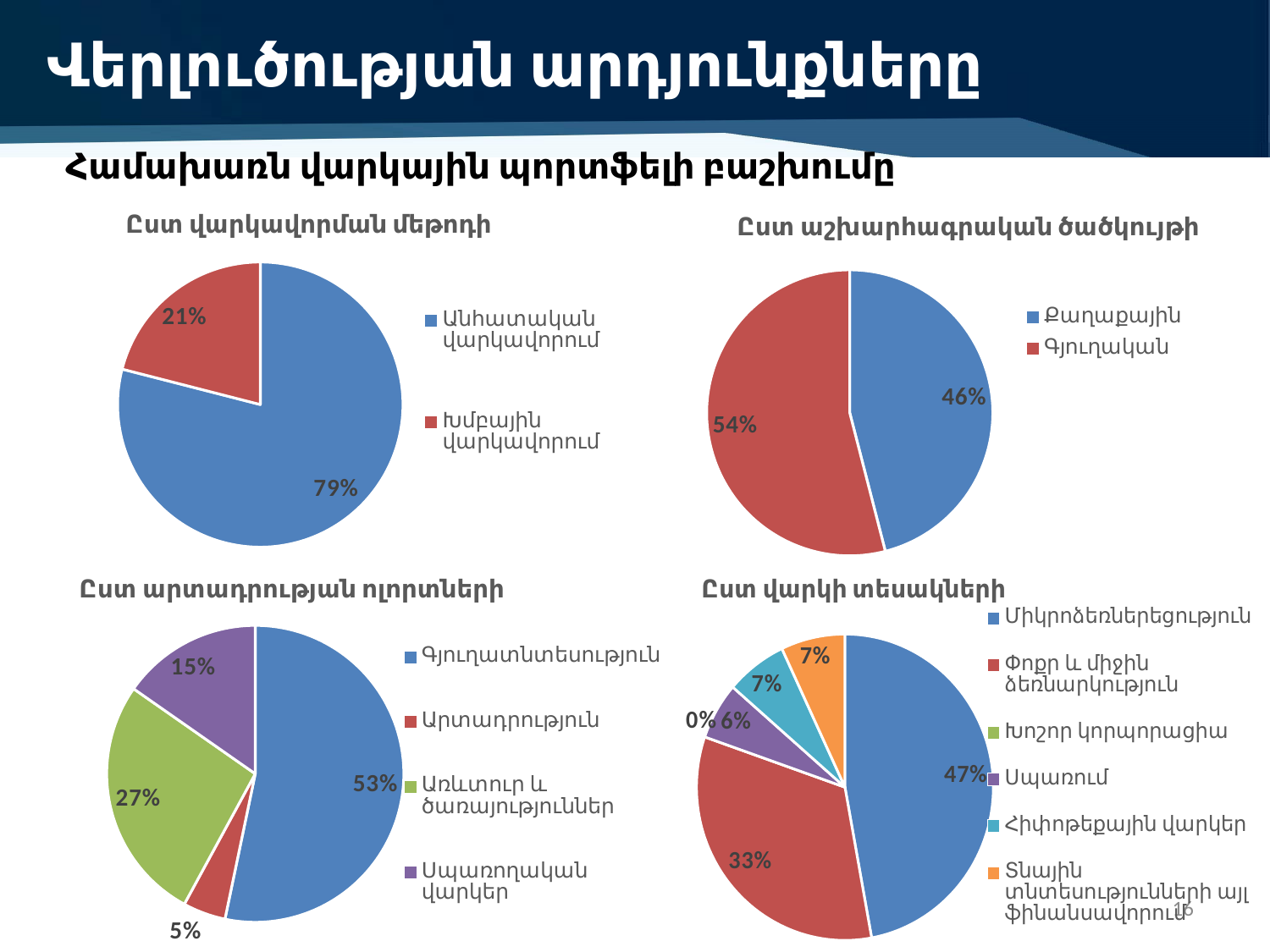
In the chart titled "Ըստ վարկի տեսակների", what is the value for "Փոքր և միջին ձեռնարկություն"? 33% What type of chart is used for "Ըստ վարկավորման մեթոդի"? Pie chart In the chart titled "Ըստ վարկավորման մեթոդի", what is the value for "Խմբային վարկավորում"? 21% In the chart titled "Ըստ վարկի տեսակների", what is the value for "Խոշոր կորպորացիա"? 0% In the chart titled "Ըստ վարկավորման մեթոդի", what share does "Անհատական վարկավորում" have? 79% In the chart titled "Ըստ վարկի տեսակների", which category has the largest share? Միկրոձեռներեցություն In the chart titled "Ըստ աշխարհագրական ծածկույթի", what is the difference between the "Գյուղական" and "Քաղաքային" shares? 8% In the chart titled "Ըստ արտադրության ոլորտների", how many categories does the legend list? 4 In the chart titled "Ըստ վարկի տեսակների", how many categories does the legend list? 6 In the chart titled "Ըստ արտադրության ոլորտների", which category has the smallest share? Արտադրություն In the chart titled "Ըստ աշխարհագրական ծածկույթի", which category has the larger share? Գյուղական In the chart titled "Ըստ արտադրության ոլորտների", what share does "Առևտուր և ծառայություններ" have? 27%